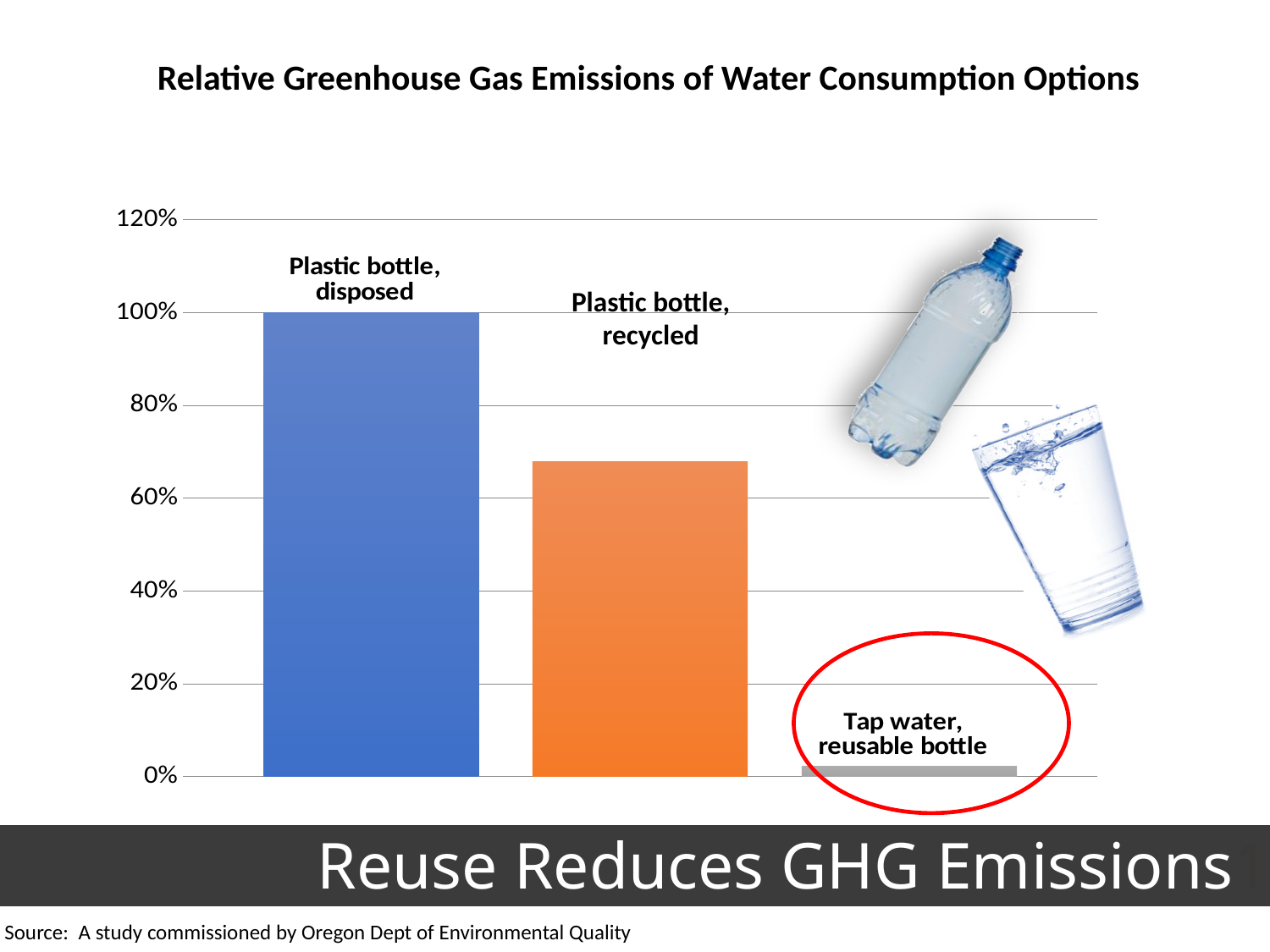
Do the values rise or fall moving from left to right across the bars? fall What is the title of the chart? Relative Greenhouse Gas Emissions of Water Consumption Options Which is larger, the value for Plastic bottle, disposed or Plastic bottle, recycled? Plastic bottle, disposed What kind of chart is shown on the slide? bar chart How many categories (bars) does the chart show? 3 Is the value for Plastic bottle, recycled greater or less than 60%? greater Is the value for Plastic bottle, recycled greater or less than 80%? less Which category's bar is circled in red on the chart? Tap water, reusable bottle Is the value for Tap water, reusable bottle greater or less than 20%? less What is the value for Plastic bottle, disposed? 100% Which category has the highest value? Plastic bottle, disposed Which category has the lowest value? Tap water, reusable bottle